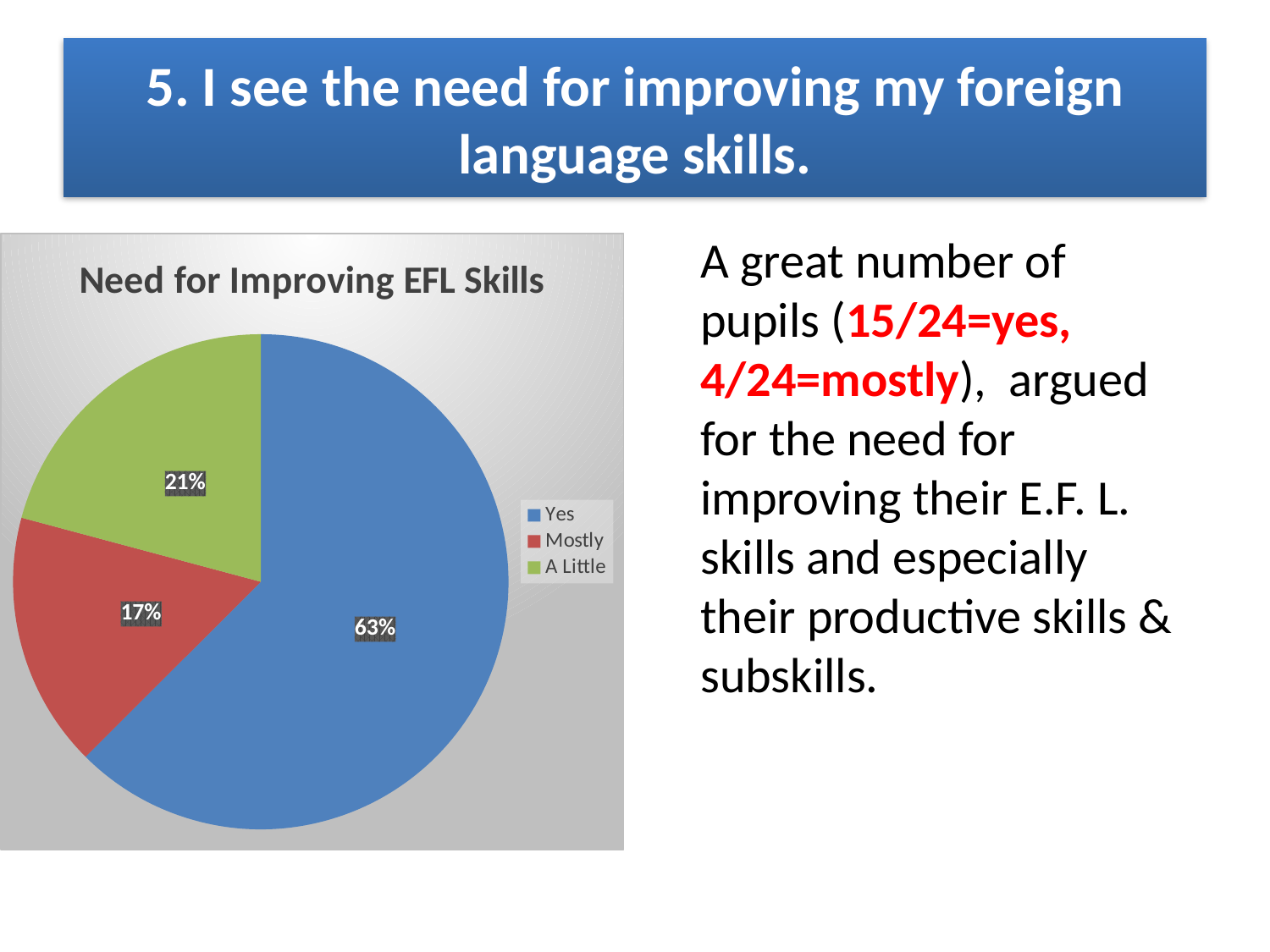
Which category has the smallest share of the pie? Mostly How many slices does the pie chart have? 3 What percentage of the pie is labelled for the Yes slice? 63% Which slice is larger, A Little or Mostly? A Little What is the title of the chart? Need for Improving EFL Skills What percentage of the pie is labelled for the A Little slice? 21% What is the difference in percentage points between the Yes slice and the A Little slice? 42 What colour is the Yes slice in the pie chart? blue Which category has the largest share of the pie? Yes How many categories does the legend list? 3 What percentage of the pie is labelled for the Mostly slice? 17% What type of chart is shown on the slide? pie chart